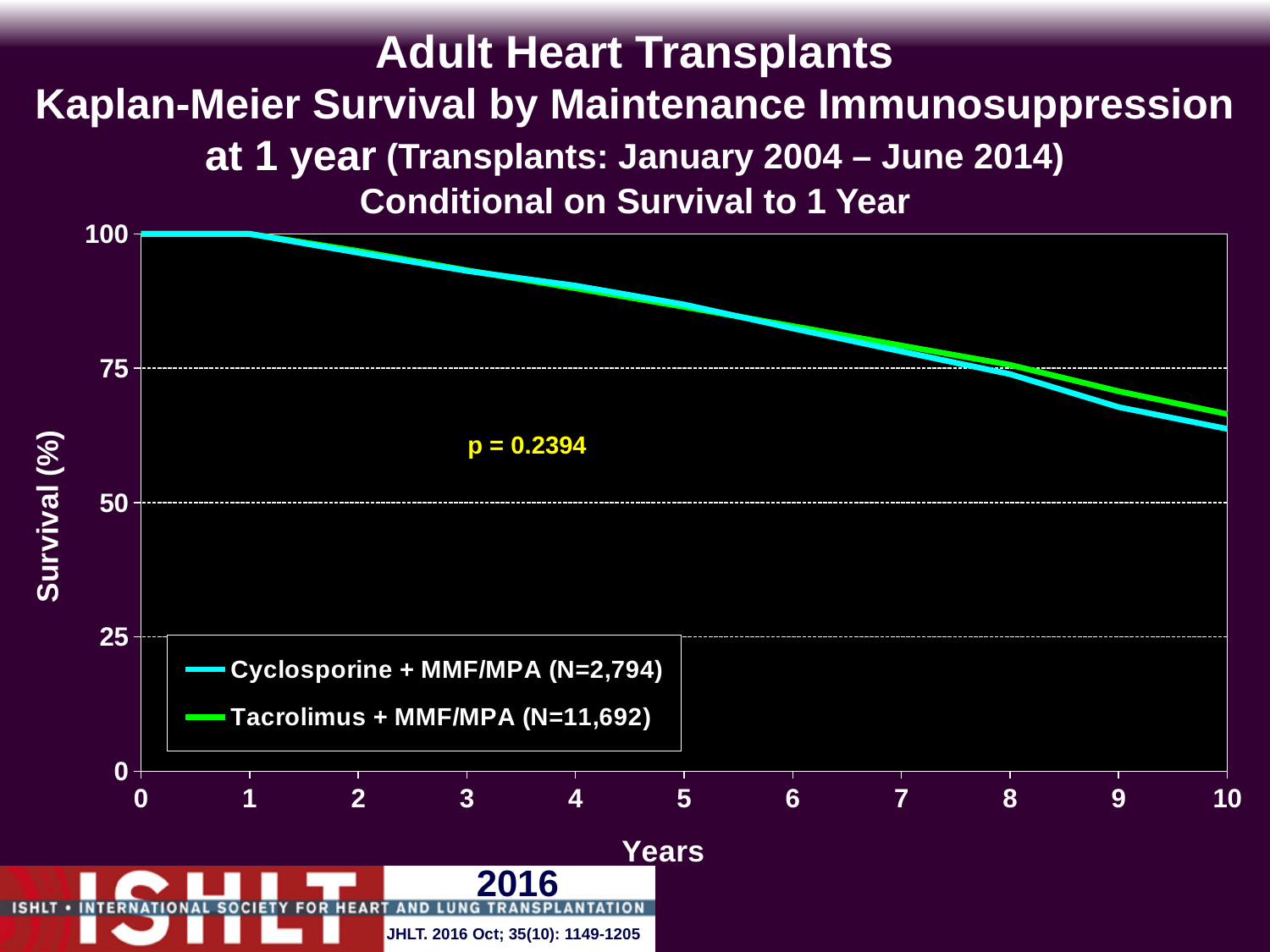
What p-value is printed on the chart? p = 0.2394 Is the survival value for Cyclosporine + MMF/MPA at 10 years greater or less than 75? less Is the survival value for Tacrolimus + MMF/MPA at 10 years greater or less than 50? greater How many series does the legend list? 2 Which colour represents the Cyclosporine + MMF/MPA series? Cyan (light blue) Is the survival value for Tacrolimus + MMF/MPA at 5 years greater or less than 75? greater What kind of chart is shown on the slide? Line chart At 10 years, which group has the higher survival: Cyclosporine + MMF/MPA or Tacrolimus + MMF/MPA? Tacrolimus + MMF/MPA What is the sample size (N) for the Tacrolimus + MMF/MPA group shown in the legend? 11,692 What is the label of the y-axis? Survival (%) What is the sample size (N) for the Cyclosporine + MMF/MPA group shown in the legend? 2,794 Do the survival curves rise or fall as years increase? Fall